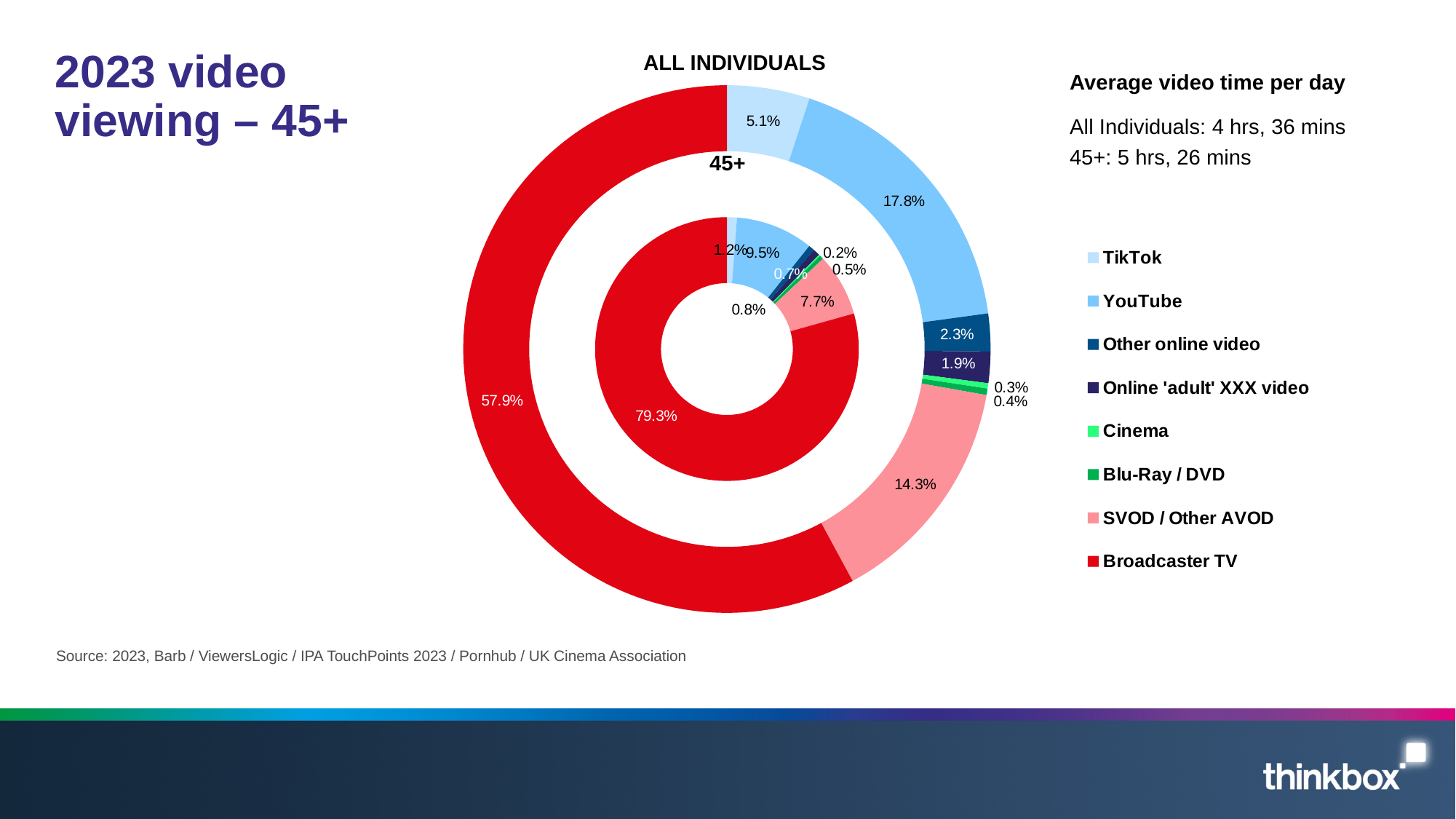
In the inner ring (45+), what is the value for SVOD / Other AVOD? 7.7% In the outer ring (All Individuals), which is larger: YouTube or SVOD / Other AVOD? YouTube In the outer ring (All Individuals), what is the value for YouTube? 17.8% How many categories does the legend list? 8 What type of chart is shown on the slide? Doughnut chart Which category has the largest share in the outer ring (All Individuals)? Broadcaster TV In the inner ring (45+), what share of video viewing is Broadcaster TV? 79.3% What is the difference between the Broadcaster TV share for 45+ (inner ring) and for All Individuals (outer ring)? 21.4 percentage points In the outer ring (All Individuals), what is the value for SVOD / Other AVOD? 14.3% Which category has the smallest share in the outer ring (All Individuals)? Cinema According to the text on the slide, what is the average video time per day for 45+? 5 hrs, 26 mins In the outer ring (All Individuals), what share of video viewing is Broadcaster TV? 57.9%